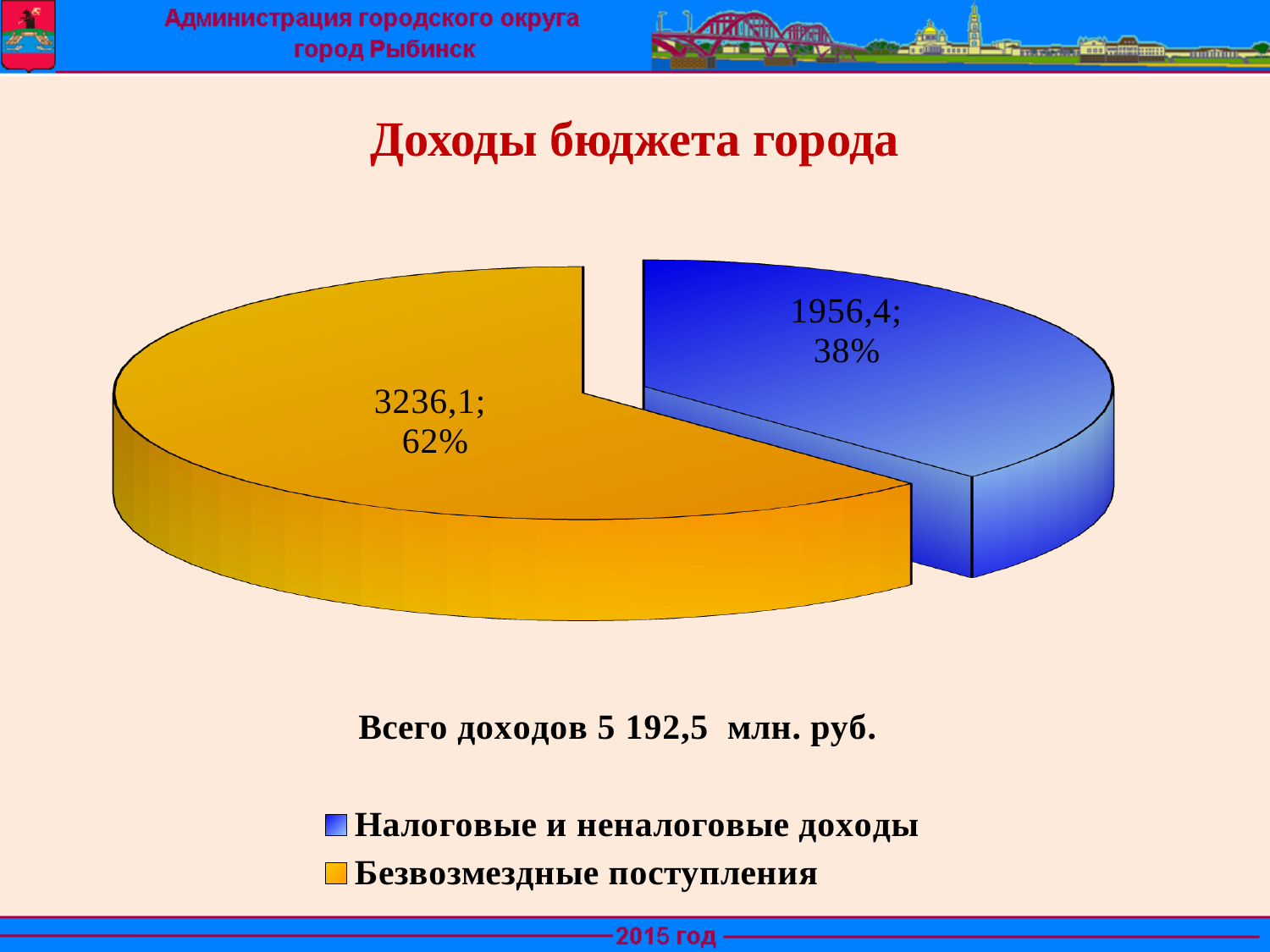
What share of the pie does Безвозмездные поступления take? 62% What share of the pie does Налоговые и неналоговые доходы take? 38% Which colour represents Налоговые и неналоговые доходы in the legend? blue What is the difference between the values for Безвозмездные поступления and Налоговые и неналоговые доходы? 1279,7 What is the title of the chart? Доходы бюджета города What kind of chart is shown on the slide? pie chart Which category has the smallest slice of the pie? Налоговые и неналоговые доходы What is the value for Безвозмездные поступления? 3236,1 Which is larger: Налоговые и неналоговые доходы or Безвозмездные поступления? Безвозмездные поступления How many slices does the pie chart have? 2 What is the value for Налоговые и неналоговые доходы? 1956,4 Which category has the largest slice of the pie? Безвозмездные поступления